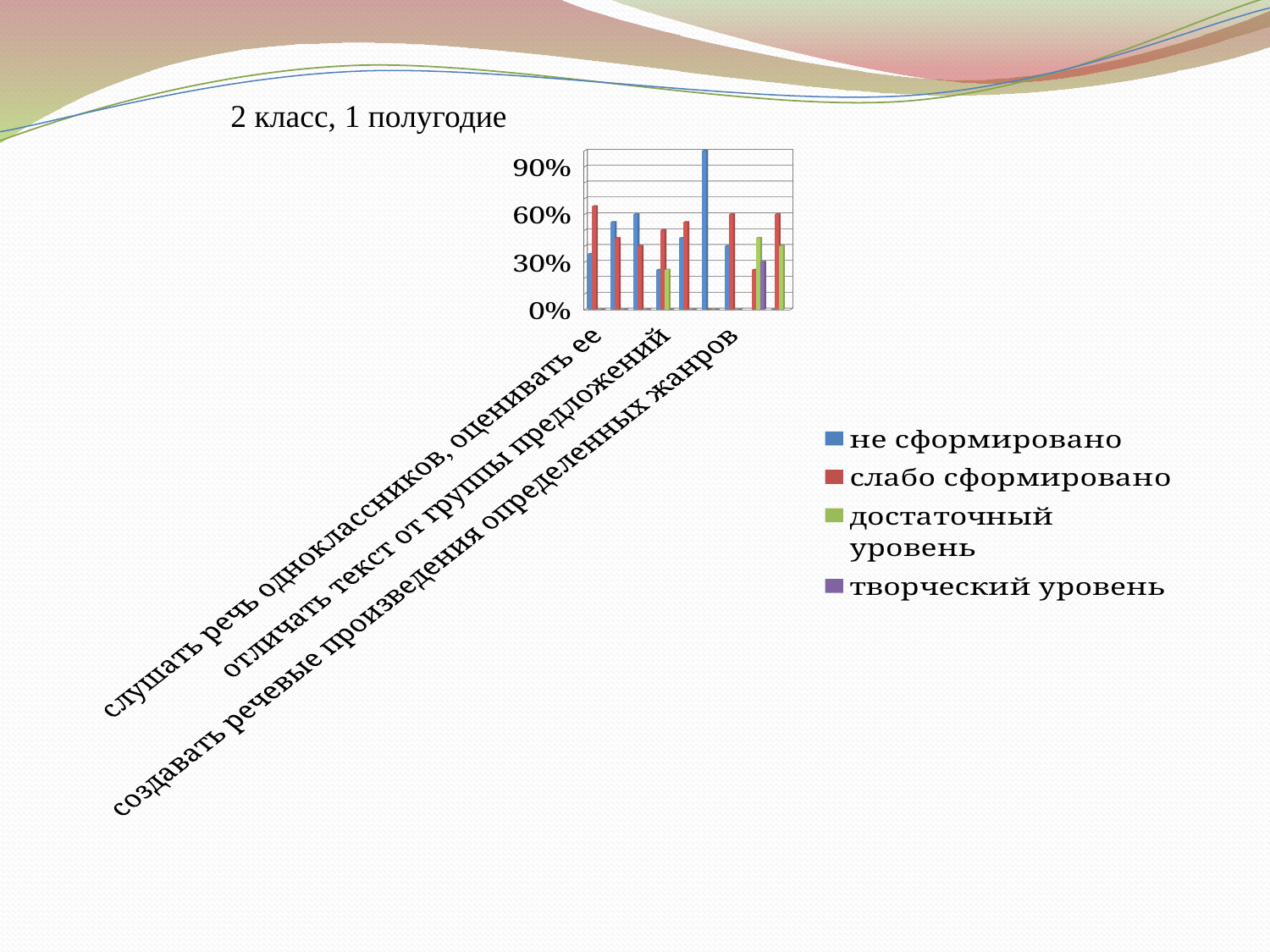
How many groups of bars are plotted on the chart? 9 What is the title shown above the chart? 2 класс, 1 полугодие Which series has the tallest bar on the chart? не сформировано How many series does the legend list? 4 Is the tallest bar on the chart greater or less than 90%? greater What is the highest labelled tick on the vertical axis? 90% What kind of chart is shown on the slide? bar chart Which legend entry is shown in blue? не сформировано